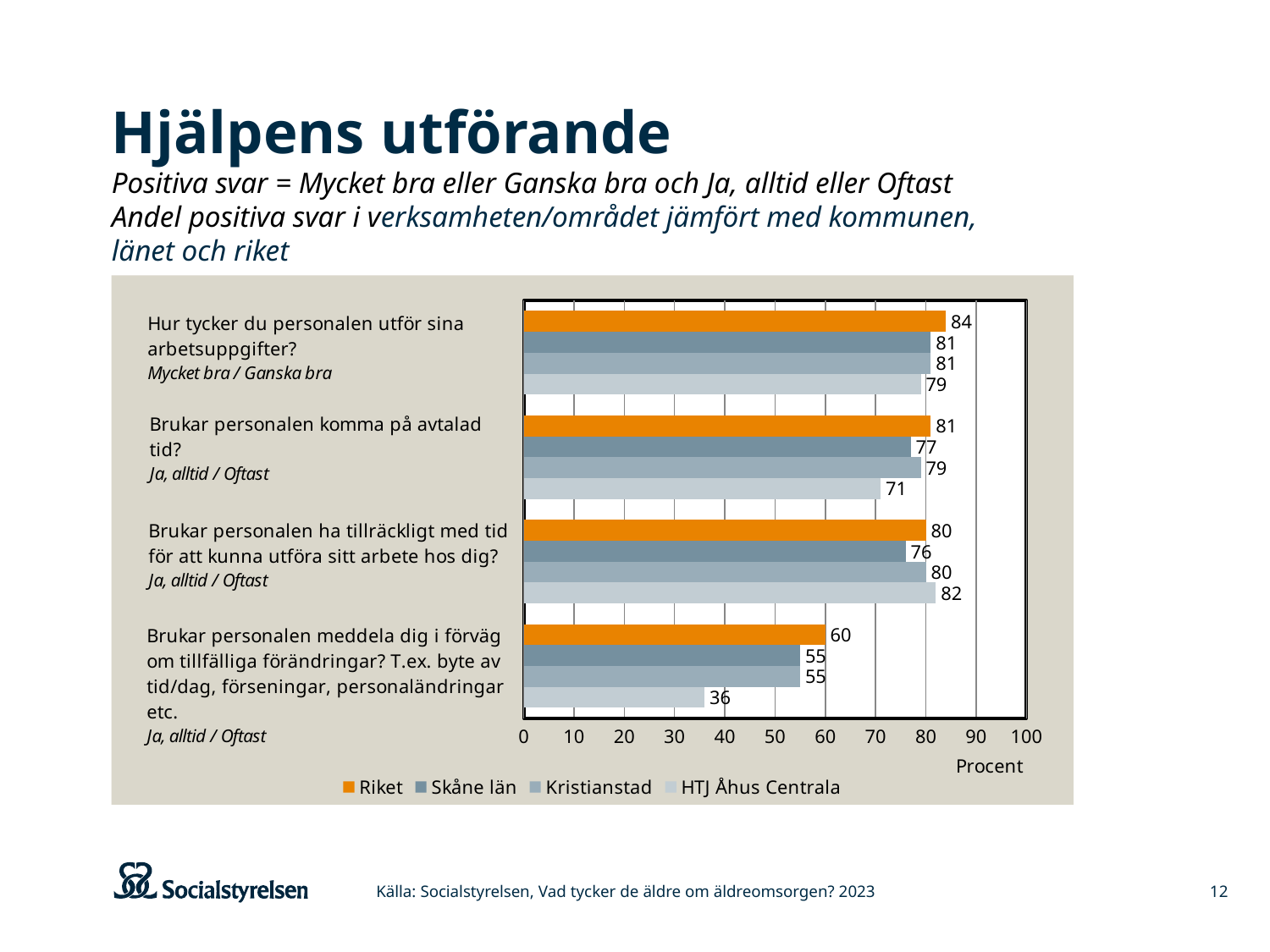
What is the label on the x axis of the chart? Procent Which is larger on "Brukar personalen komma på avtalad tid?": Kristianstad or Skåne län? Kristianstad What is the value for HTJ Åhus Centrala on "Brukar personalen meddela dig i förväg om tillfälliga förändringar?"? 36 What is the value for Skåne län on "Brukar personalen ha tillräckligt med tid för att kunna utföra sitt arbete hos dig?"? 76 What is the value for Riket on "Hur tycker du personalen utför sina arbetsuppgifter?"? 84 What is the difference between Riket and HTJ Åhus Centrala on "Brukar personalen meddela dig i förväg om tillfälliga förändringar?"? 24 What kind of chart is shown on the slide? bar chart How many series does the legend list? 4 How many question categories are plotted in the chart? 4 Which series has the lowest value on "Brukar personalen meddela dig i förväg om tillfälliga förändringar?"? HTJ Åhus Centrala What is the value for HTJ Åhus Centrala on "Brukar personalen komma på avtalad tid?"? 71 Which series has the highest value on "Brukar personalen ha tillräckligt med tid för att kunna utföra sitt arbete hos dig?"? HTJ Åhus Centrala